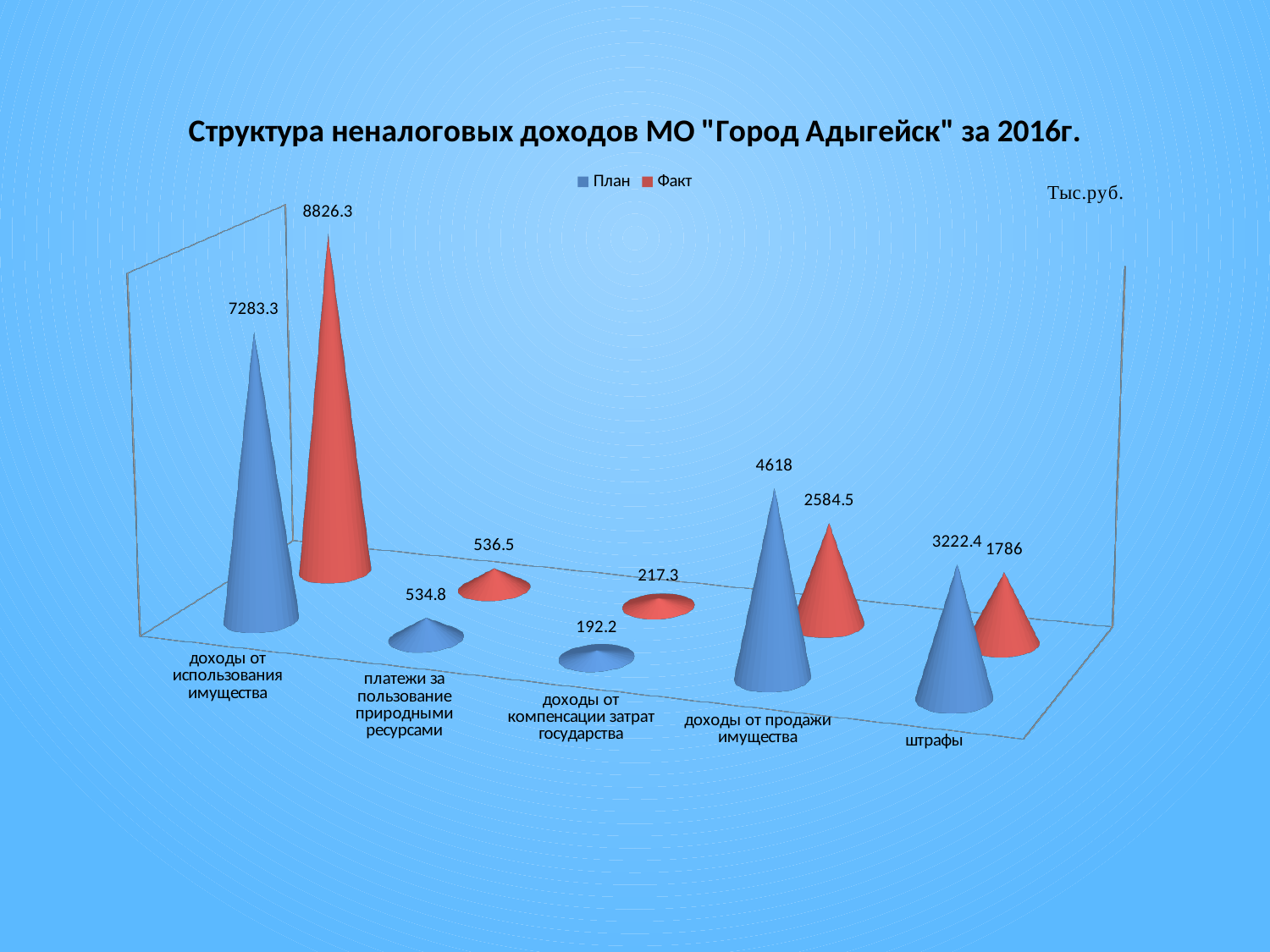
What is the Факт value for доходы от продажи имущества? 2584.5 Which category has the lowest План value? доходы от компенсации затрат государства What is the difference between the План and Факт values for доходы от продажи имущества? 2033.5 For штрафы, which is larger: План or Факт? План What is the План value for доходы от компенсации затрат государства? 192.2 What is the Факт value for штрафы? 1786 How many categories are shown on the x axis? 5 How many series does the legend list? 2 What unit is indicated for the values on the chart? Тыс.руб. Which category has the highest Факт value? доходы от использования имущества What is the План value for доходы от использования имущества? 7283.3 What is the difference between the Факт and План values for доходы от использования имущества? 1543